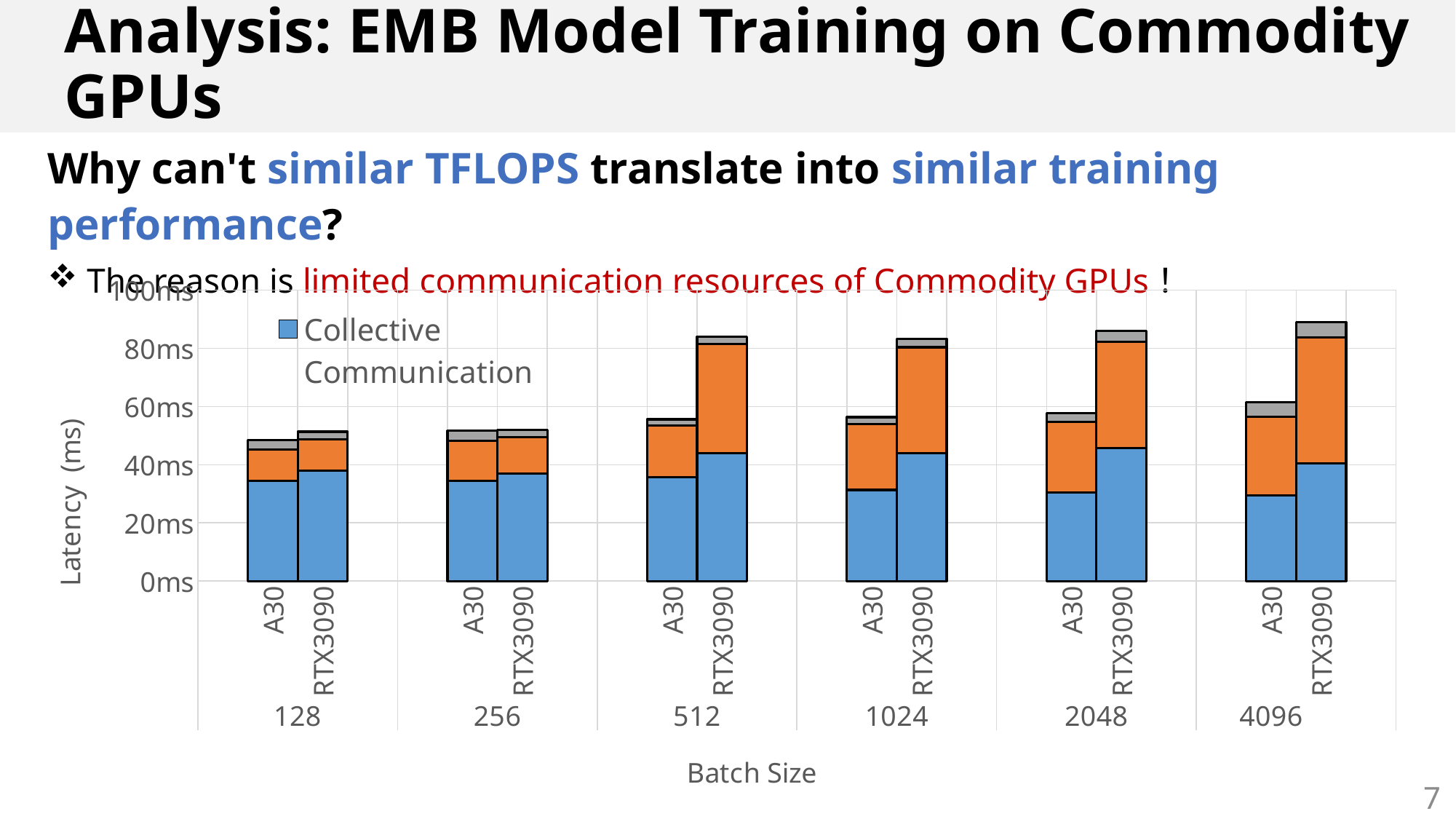
At batch size 512, which GPU has the higher total latency, A30 or RTX3090? RTX3090 Is the total latency for A30 at batch size 128 greater or less than 60ms? less Is the total latency for RTX3090 at batch size 512 greater or less than 80ms? greater What is the label of the chart's y axis? Latency (ms) At batch size 4096, which GPU has the lower total latency, A30 or RTX3090? A30 How many bars are plotted in the chart in total? 12 Does the total latency for A30 rise or fall as batch size increases from 128 to 4096? rises How many batch sizes are shown on the x axis of the chart? 6 What kind of chart is shown on the slide? stacked bar chart Which series is named in the chart's legend? Collective Communication Is the Collective Communication value for RTX3090 at batch size 2048 greater or less than 40ms? greater